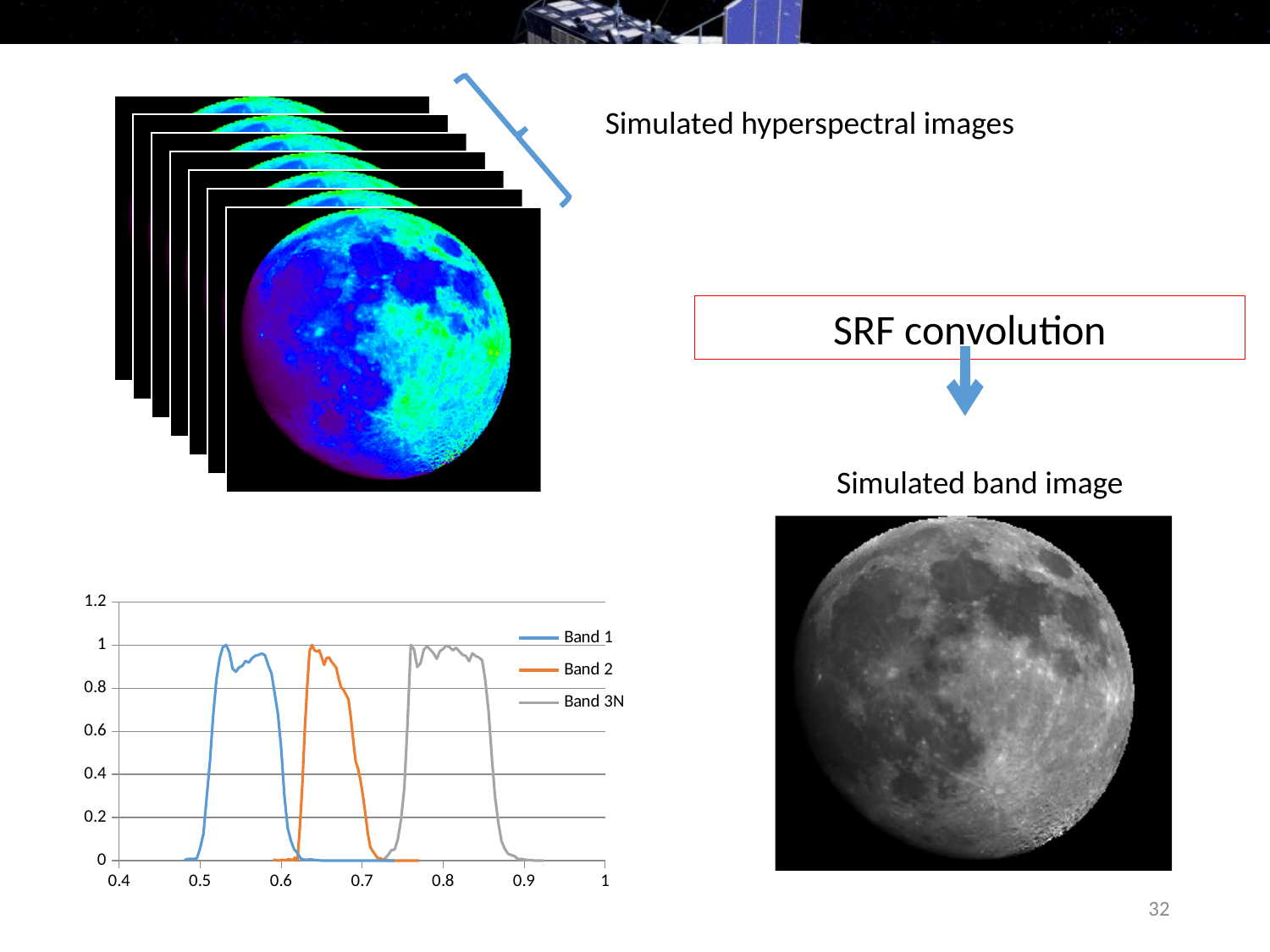
Is the value of Band 2 at x = 0.5 greater or less than 0.2? less Is the value of Band 2 at x = 0.65 greater or less than 0.8? greater Is the value of Band 1 at x = 0.7 greater or less than 0.2? less At x = 0.8, which series has the larger value, Band 1 or Band 3N? Band 3N What colour is the Band 2 line in the chart? orange What are the names of the series listed in the chart's legend? Band 1, Band 2, Band 3N What kind of chart is shown on the slide? line chart How many series does the chart's legend list? 3 Which series in the chart has its peak at the largest x values? Band 3N